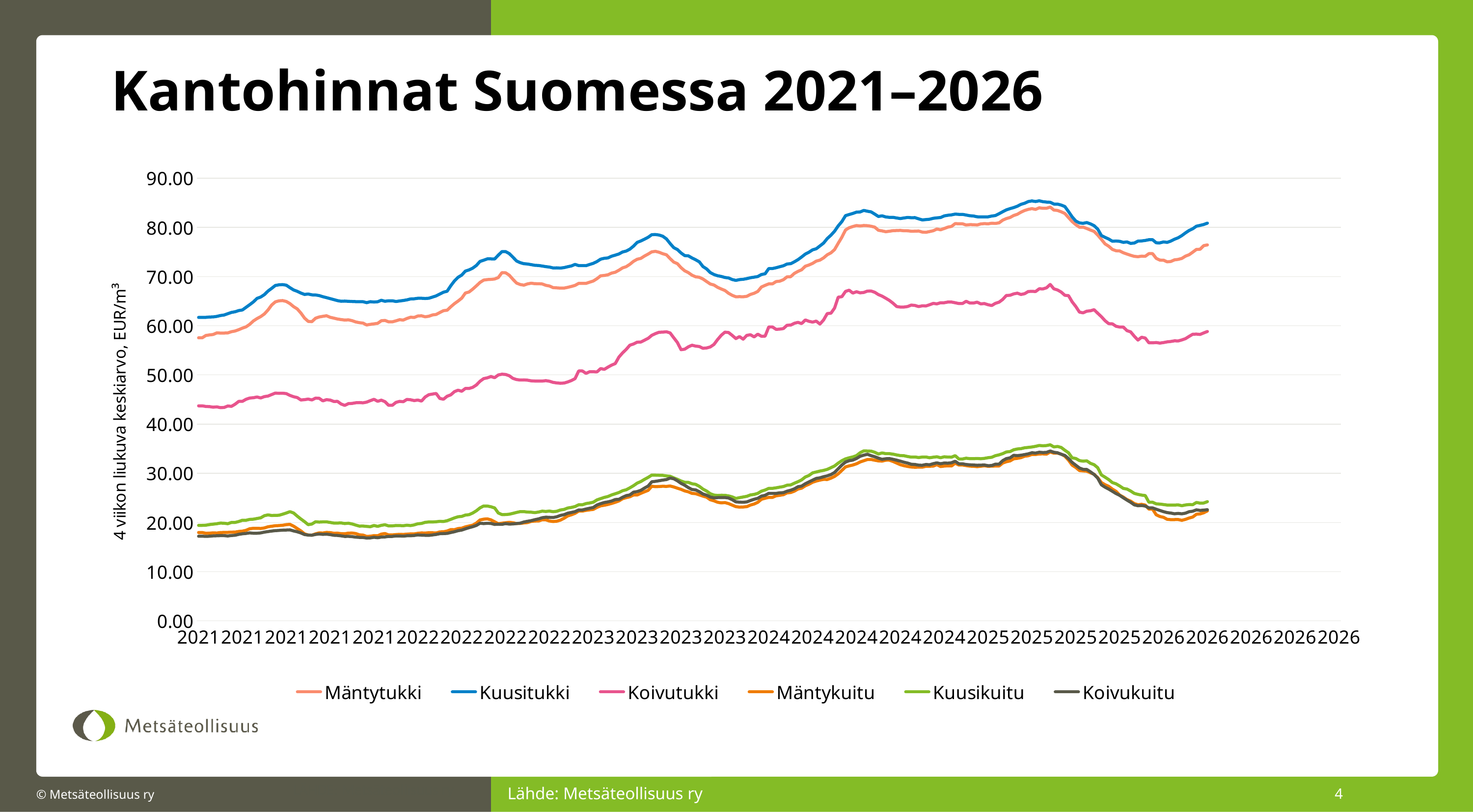
Is the value of Mäntytukki at the start of 2021 greater or less than 50? greater Is the highest value reached by Kuusitukki greater or less than 80? greater How many series stay above 40 for the entire period? 3 What type of chart is shown on the slide? Line chart Is the highest value reached by Kuusikuitu greater or less than 40? less How many series does the legend list? 6 What is the label of the vertical axis? 4 viikon liukuva keskiarvo, EUR/m³ Which series has the highest values across the whole period? Kuusitukki Does the Koivutukki series generally rise or fall from 2021 to 2024? rise Which series is higher throughout the period, Kuusitukki or Koivutukki? Kuusitukki What is the title of the chart? Kantohinnat Suomessa 2021–2026